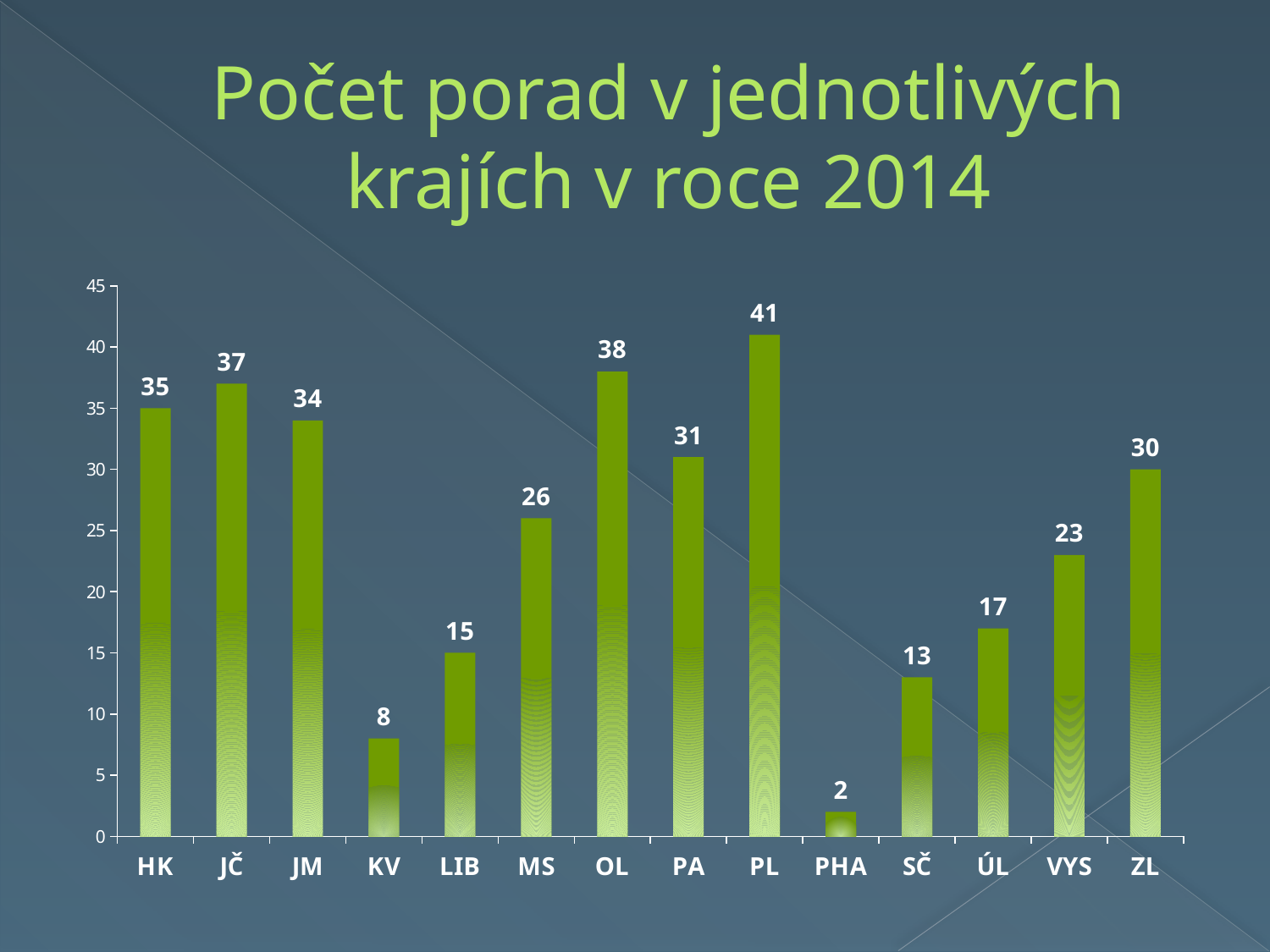
What is the difference between the values for JČ and KV? 29 What is the title of the chart on the slide? Počet porad v jednotlivých krajích v roce 2014 Which category has the lowest value? PHA How many categories are shown on the x axis? 14 What is the value for VYS? 23 What kind of chart is shown on the slide? bar chart What is the difference between the values for OL and PA? 7 Which is larger, the value for SČ or the value for ÚL? ÚL What is the value for LIB? 15 Which is larger, the value for MS or the value for ZL? ZL What is the value for PL? 41 Which category has the highest value? PL